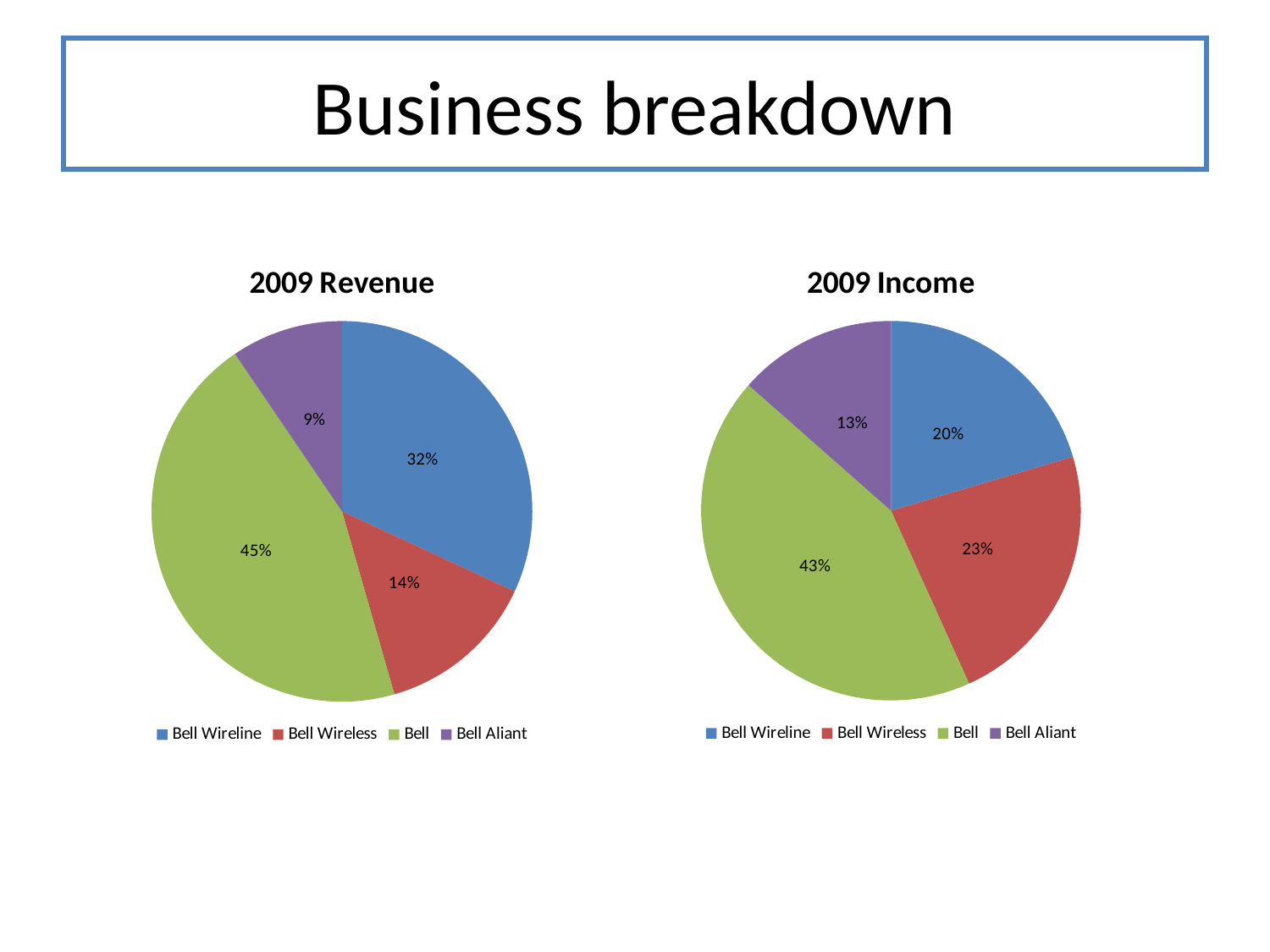
How many slices does the 2009 Revenue pie chart have? 4 In the 2009 Income chart, what share does Bell have? 43% In the 2009 Income chart, which segment has the smallest share? Bell Aliant In the 2009 Revenue chart, what share does Bell Aliant have? 9% In the 2009 Revenue chart, which segment has the largest share? Bell In the 2009 Income chart, which is larger, Bell Wireline or Bell Wireless? Bell Wireless In the 2009 Income chart, what is the difference between the Bell Wireline share and the Bell Aliant share? 7% In the 2009 Income chart, what share does Bell Wireless have? 23% In the 2009 Revenue chart, what colour is the Bell Wireless slice? Red In the 2009 Revenue chart, what is the difference between the Bell Wireline share and the Bell Wireless share? 18% What type of chart is the 2009 Income chart? Pie chart In the 2009 Revenue chart, what share does Bell Wireline have? 32%